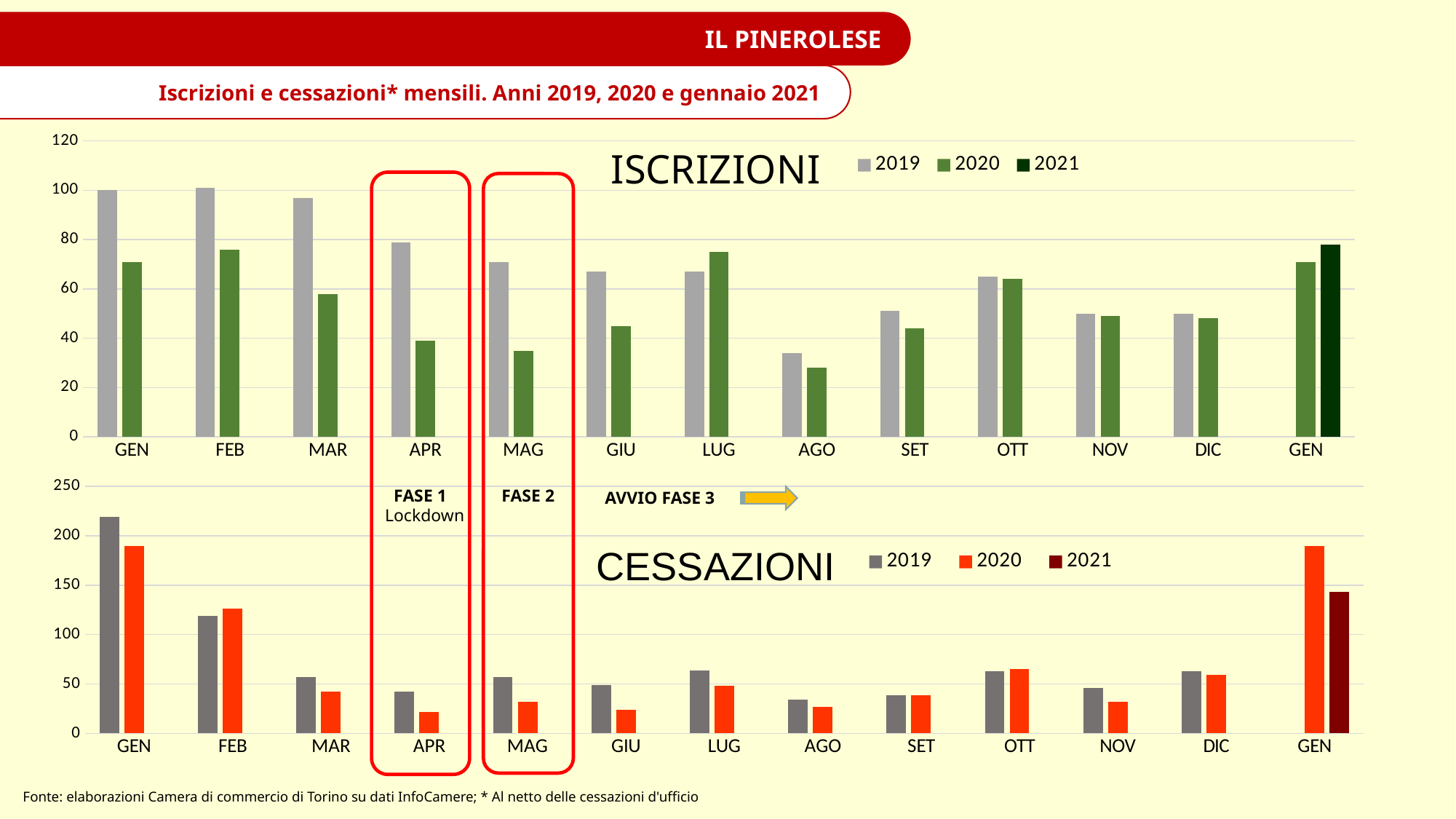
In the CESSAZIONI chart, which is larger for GEN: the 2019 value or the 2020 value? 2019 How many series does the legend of the ISCRIZIONI chart list? 3 In the ISCRIZIONI chart, is the 2020 value for MAG greater or less than 60? less In the CESSAZIONI chart, is the 2020 value for APR greater or less than 50? less In the CESSAZIONI chart, is the 2021 value for GEN greater or less than 100? greater What kind of chart is the ISCRIZIONI chart at the top of the slide? bar chart In the ISCRIZIONI chart, which month has the lowest 2020 value? AGO In the CESSAZIONI chart, which month has the highest 2019 value? GEN In the ISCRIZIONI chart, do the 2019 values rise or fall from GEN to APR? fall How many month categories are shown along the x axis of the CESSAZIONI chart? 13 In the ISCRIZIONI chart, which month has the lowest 2019 value? AGO